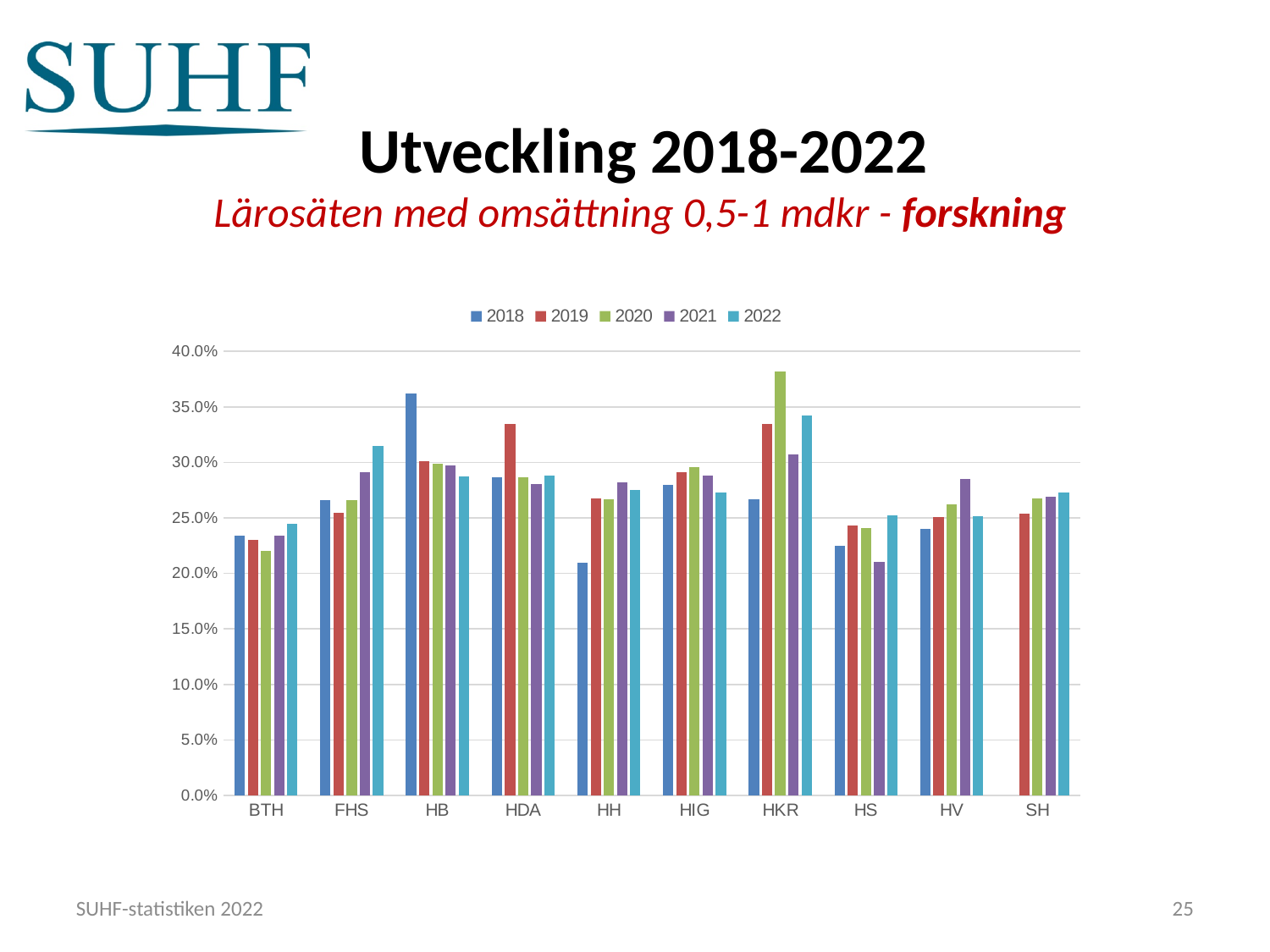
Is the value for HS in 2021 greater or less than 25.0%? less How many categories are shown on the x axis? 10 Which category has the tallest bar in the 2020 series? HKR Which category on the x axis has no bar for 2018? SH For HV, which is larger: the 2021 value or the 2018 value? 2021 What kind of chart is shown on the slide? bar chart How many series does the legend list? 5 Is the value for BTH in 2020 greater or less than 25.0%? less Which category has the tallest bar in the 2018 series? HB Is the value for HB in 2018 greater or less than 35.0%? greater For HB, which is larger: the 2018 value or the 2022 value? 2018